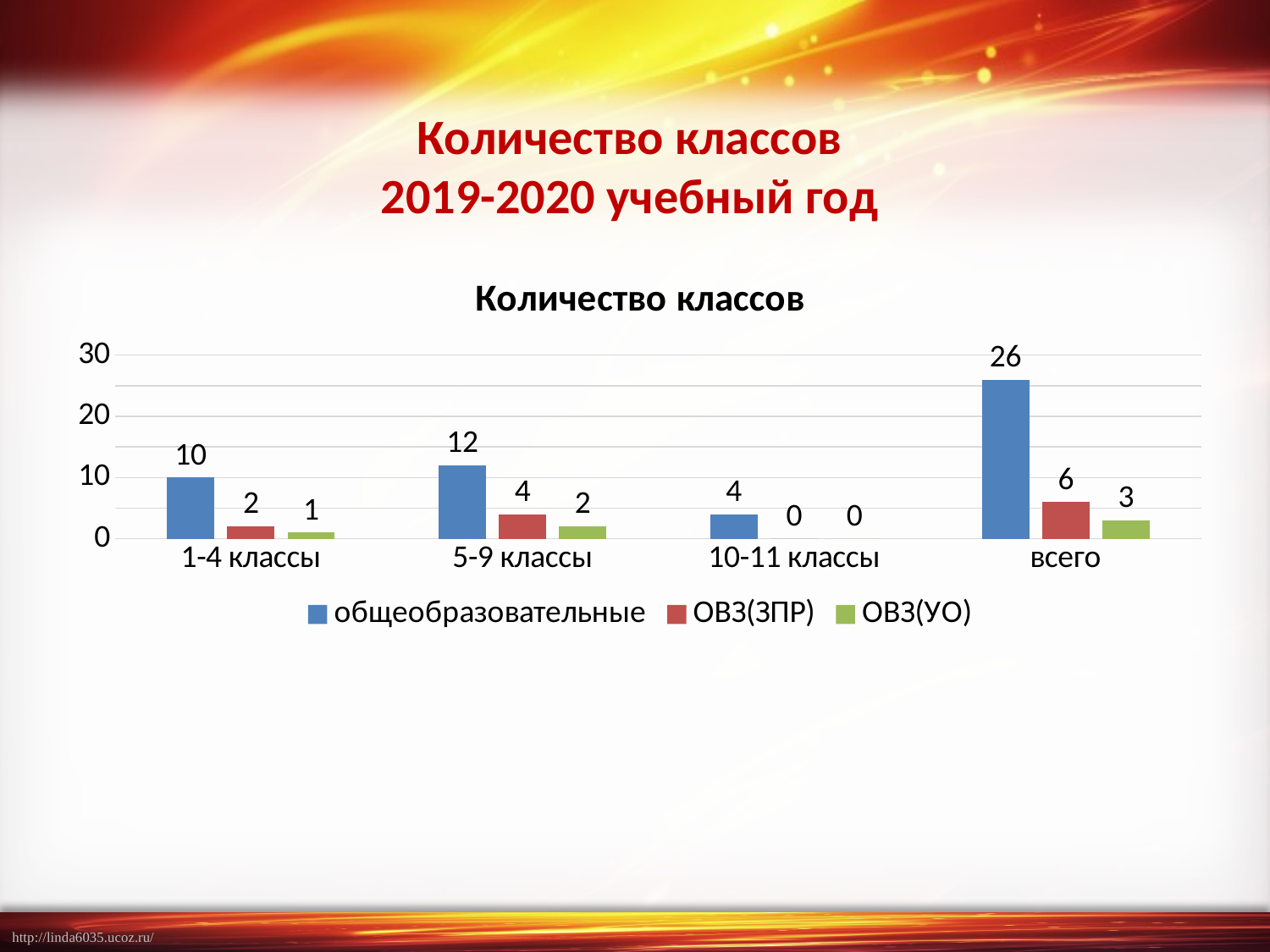
How many categories are shown on the x axis? 4 Which is larger: ОВЗ(ЗПР) for всего or ОВЗ(УО) for всего? ОВЗ(ЗПР) for всего Which category has the highest value for общеобразовательные? всего What is the difference between the общеобразовательные values for 5-9 классы and 1-4 классы? 2 Which category has the lowest value for ОВЗ(УО)? 10-11 классы What is the value for общеобразовательные in the 1-4 классы category? 10 How many series does the legend list? 3 What is the value for ОВЗ(ЗПР) in the 10-11 классы category? 0 What is the value for ОВЗ(ЗПР) in the 5-9 классы category? 4 What is the title of the chart? Количество классов What kind of chart is shown on the slide? bar chart What is the value for ОВЗ(УО) in the всего category? 3